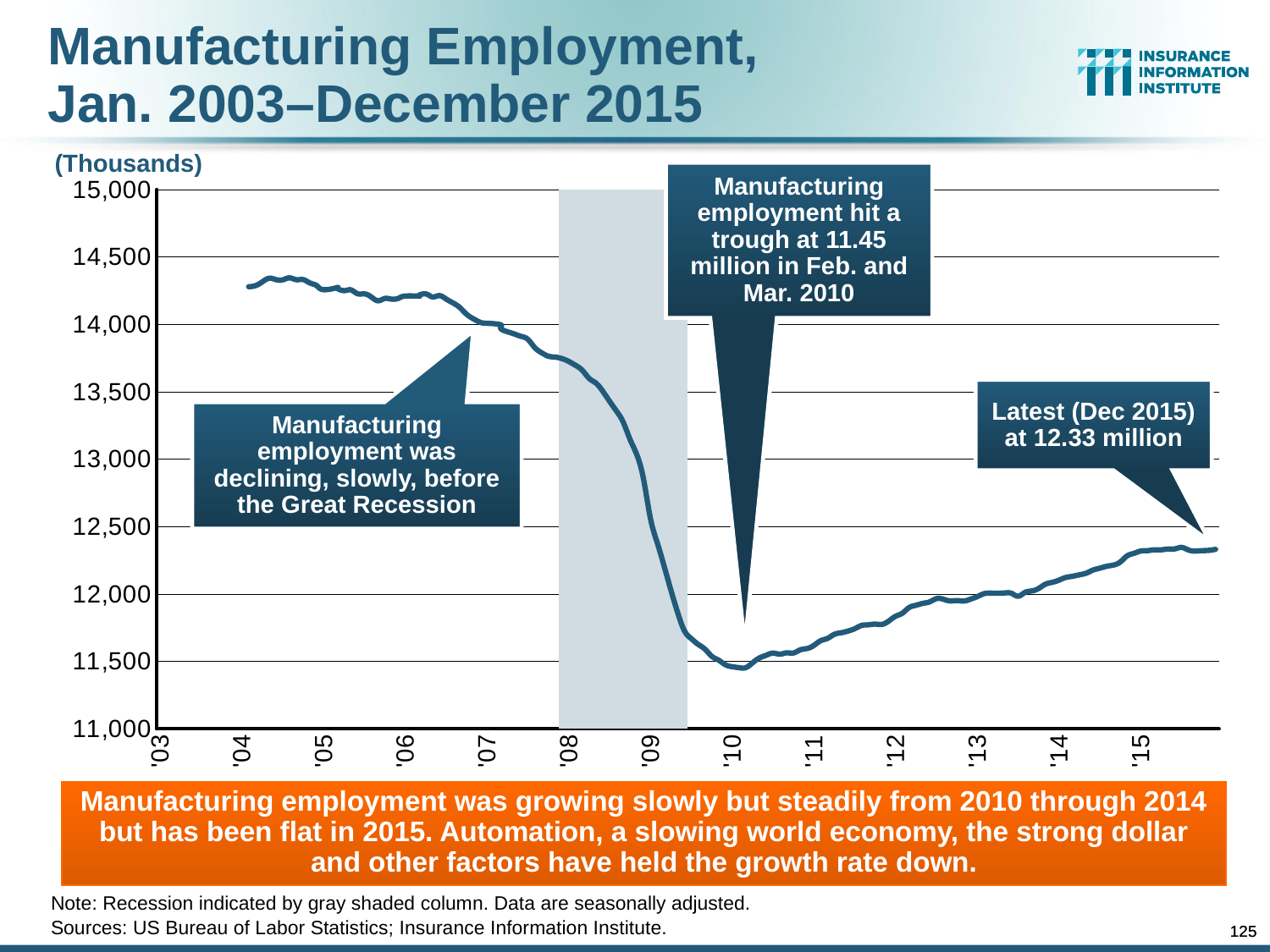
What is the latest (Dec 2015) value of manufacturing employment shown on the chart? 12.33 million Does manufacturing employment rise or fall from 2010 through 2014? rise Does manufacturing employment rise or fall between '08 and '10? fall Is the value for manufacturing employment at the start of '15 greater or less than 12,500? less Is the value for manufacturing employment at the start of '11 greater or less than 12,000? less In what units are the values on the y-axis expressed? Thousands Is the value for manufacturing employment at the start of '04 greater or less than 14,000? greater In which months did manufacturing employment hit its trough, according to the callout? Feb. and Mar. 2010 According to the callout, what level did manufacturing employment hit at its trough? 11.45 million Which is larger: manufacturing employment in Dec 2015 or at the Feb./Mar. 2010 trough? Dec 2015 What kind of chart is shown on the slide? line chart How much higher is the Dec 2015 value (12.33 million) than the trough value (11.45 million)? 0.88 million